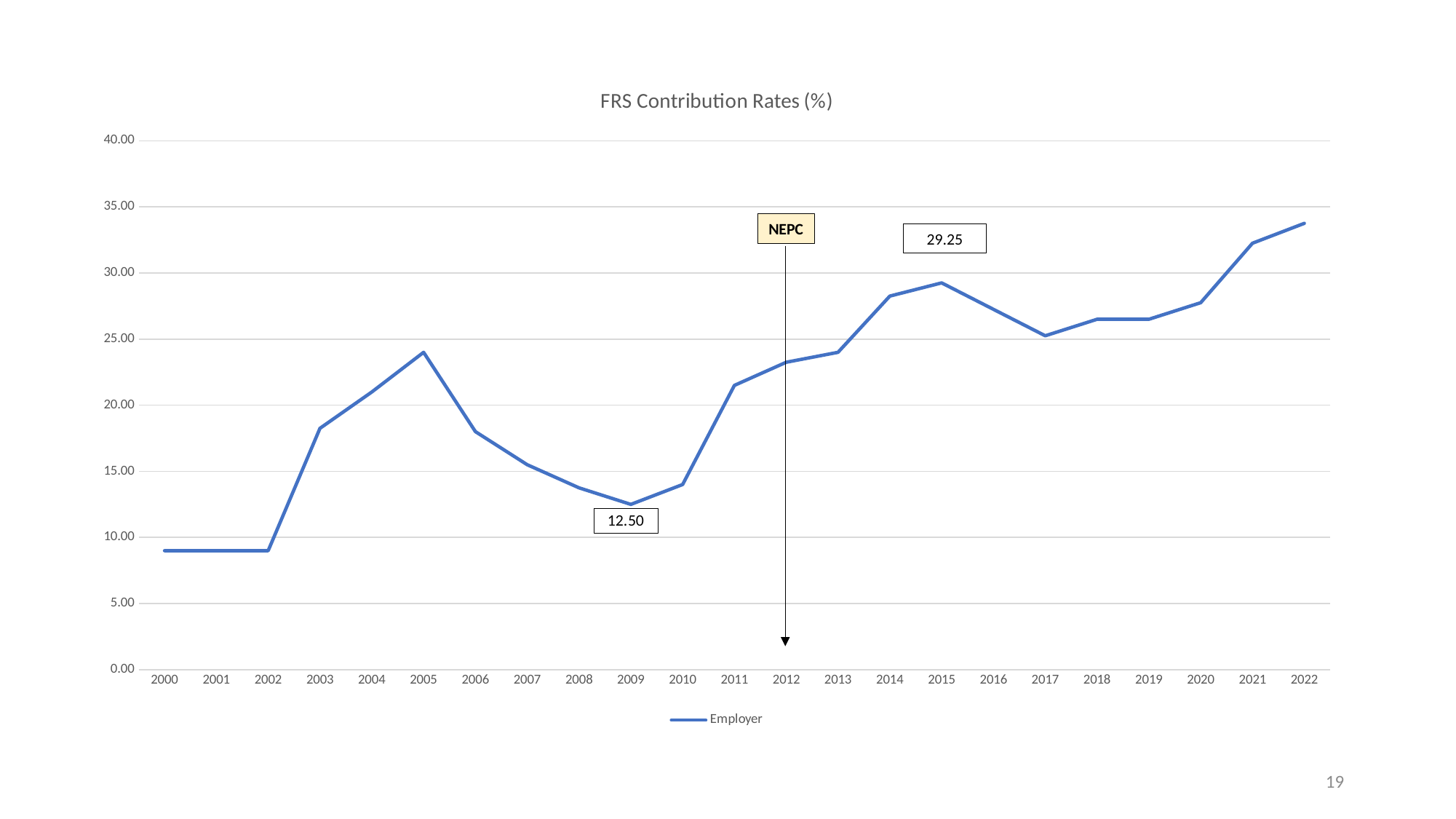
What kind of chart is shown on the slide? line chart What is the difference between the labelled values for 2015 and 2009? 16.75 Is the Employer contribution rate for 2000 greater or less than 10.00? less Is the Employer contribution rate for 2005 greater or less than 25.00? less How many series does the legend list? 1 Is the Employer contribution rate for 2021 greater or less than 30.00? greater Does the Employer contribution rate rise or fall from 2005 to 2009? fall What is the Employer contribution rate labelled for 2015? 29.25 How many years are shown on the x axis? 23 Which year has the highest Employer contribution rate? 2022 Which year has the larger Employer contribution rate, 2005 or 2015? 2015 What is the Employer contribution rate labelled for 2009? 12.50